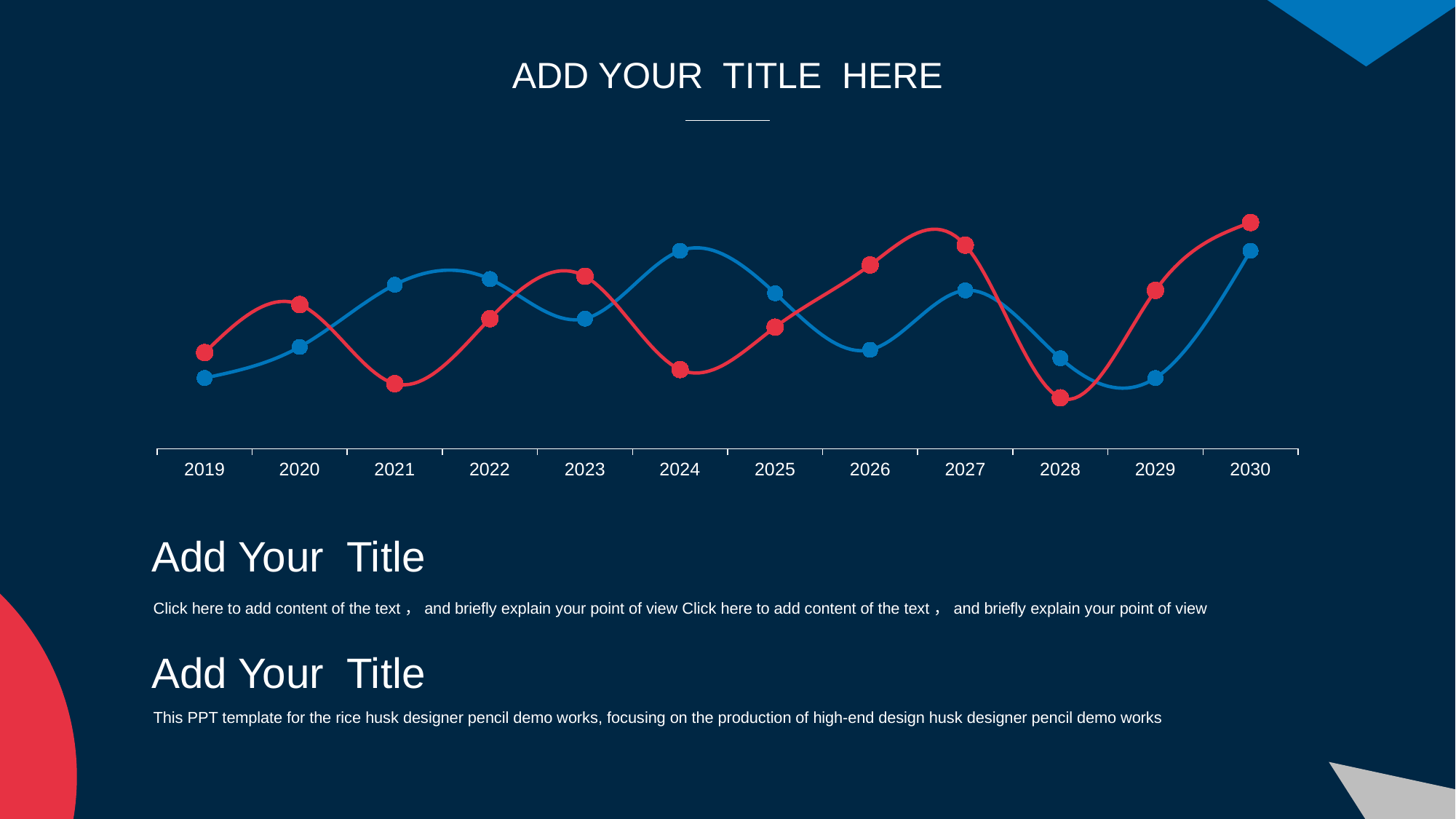
What is the first year shown on the x axis? 2019 Does the red line rise or fall from 2023 to 2024? fall Does the blue line rise or fall from 2028 to 2030? rise How many data series (lines) are plotted on the chart? 2 In 2027, which line is higher, the red line or the blue line? red line What is the last year shown on the x axis? 2030 In 2021, which line is higher, the red line or the blue line? blue line In which year does the red line reach its highest point? 2030 In 2024, which line is higher, the red line or the blue line? blue line What kind of chart is shown on the slide? line chart In which year does the red line reach its lowest point? 2028 How many years are shown along the x axis of the chart? 12